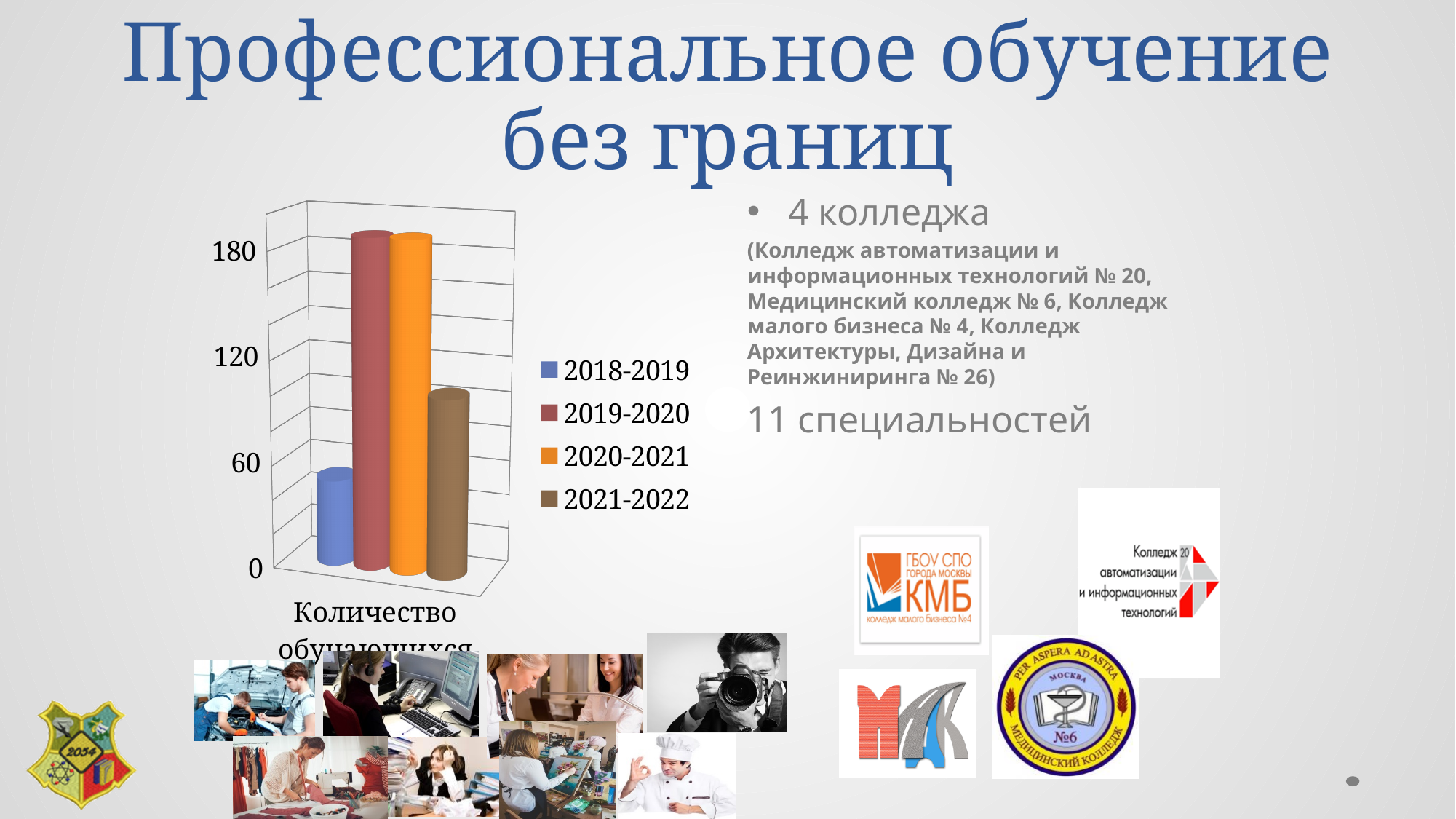
Which is larger, the value for 2019-2020 or the value for 2021-2022? 2019-2020 Is the value for 2021-2022 greater or less than 120? less Which series has the lowest value in the chart? 2018-2019 Is the value for 2020-2021 greater or less than 120? greater What is the category label shown under the bars of the chart? Количество обучающихся Is the value for 2019-2020 greater or less than 120? greater What kind of chart is shown on the slide? bar chart How many series does the chart legend list? 4 Which series is shown in orange in the chart legend? 2020-2021 How many categories are shown on the x axis of the chart? 1